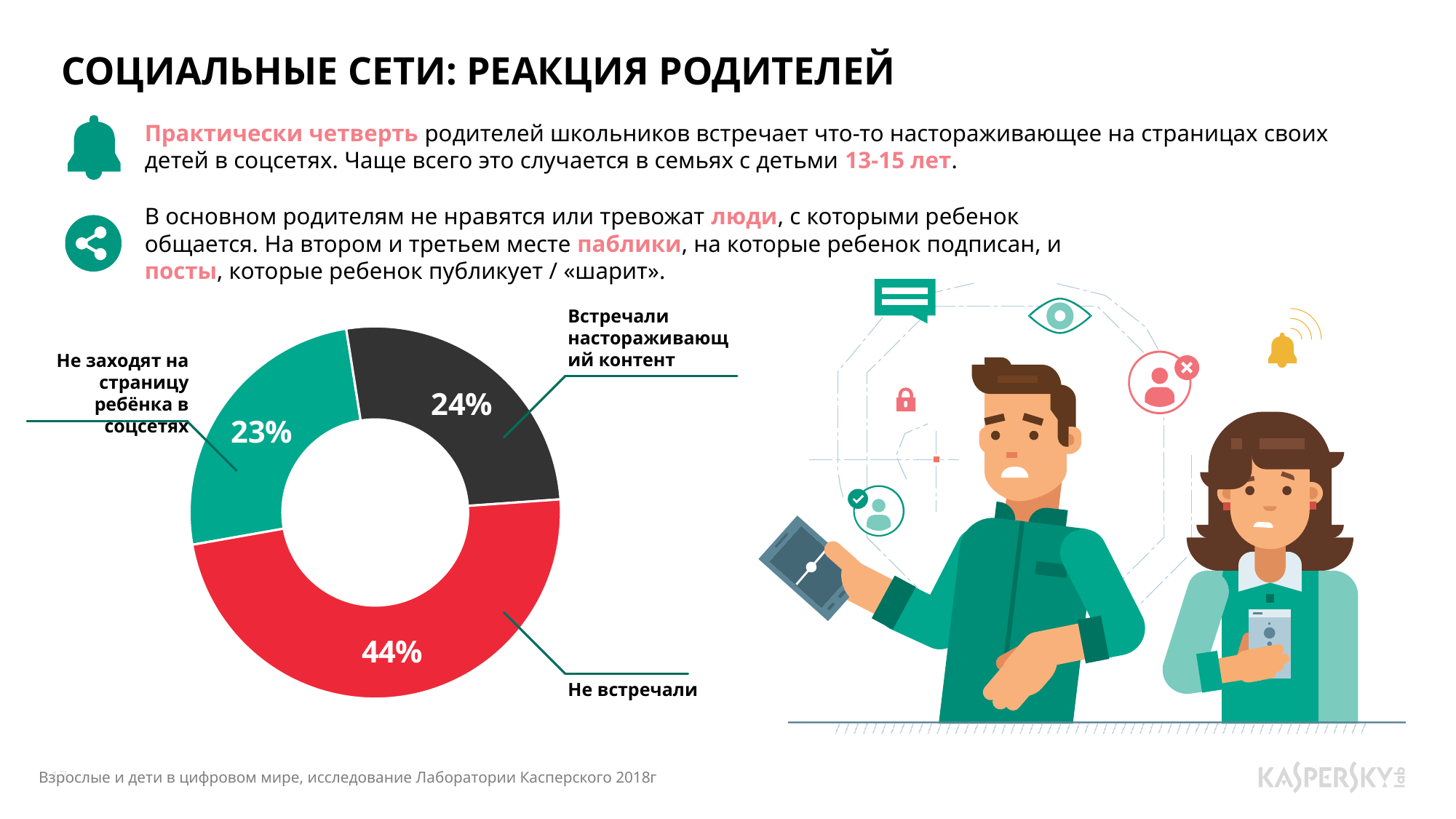
Какая доля родителей не заходят на страницу ребёнка в соцсетях? 23% Каким цветом на диаграмме показан сегмент «Не встречали»? Красным На сколько процентных пунктов доля «Встречали настораживающий контент» больше доли «Не заходят на страницу ребёнка в соцсетях»? 1 Сколько категорий показано на диаграмме? 3 На сколько процентных пунктов доля «Не встречали» больше доли «Встречали настораживающий контент»? 20 Какой тип диаграммы показан на слайде? Кольцевая (круговая) диаграмма Какая доля родителей встречали настораживающий контент на странице ребёнка? 24% Какая категория на диаграмме имеет наименьшую долю? Не заходят на страницу ребёнка в соцсетях Каким цветом на диаграмме показан сегмент «Не заходят на страницу ребёнка в соцсетях»? Зелёным Какая доля родителей не встречали настораживающий контент? 44% Что больше: доля «Не встречали» или доля «Не заходят на страницу ребёнка в соцсетях»? Не встречали Какая категория на диаграмме имеет наибольшую долю? Не встречали